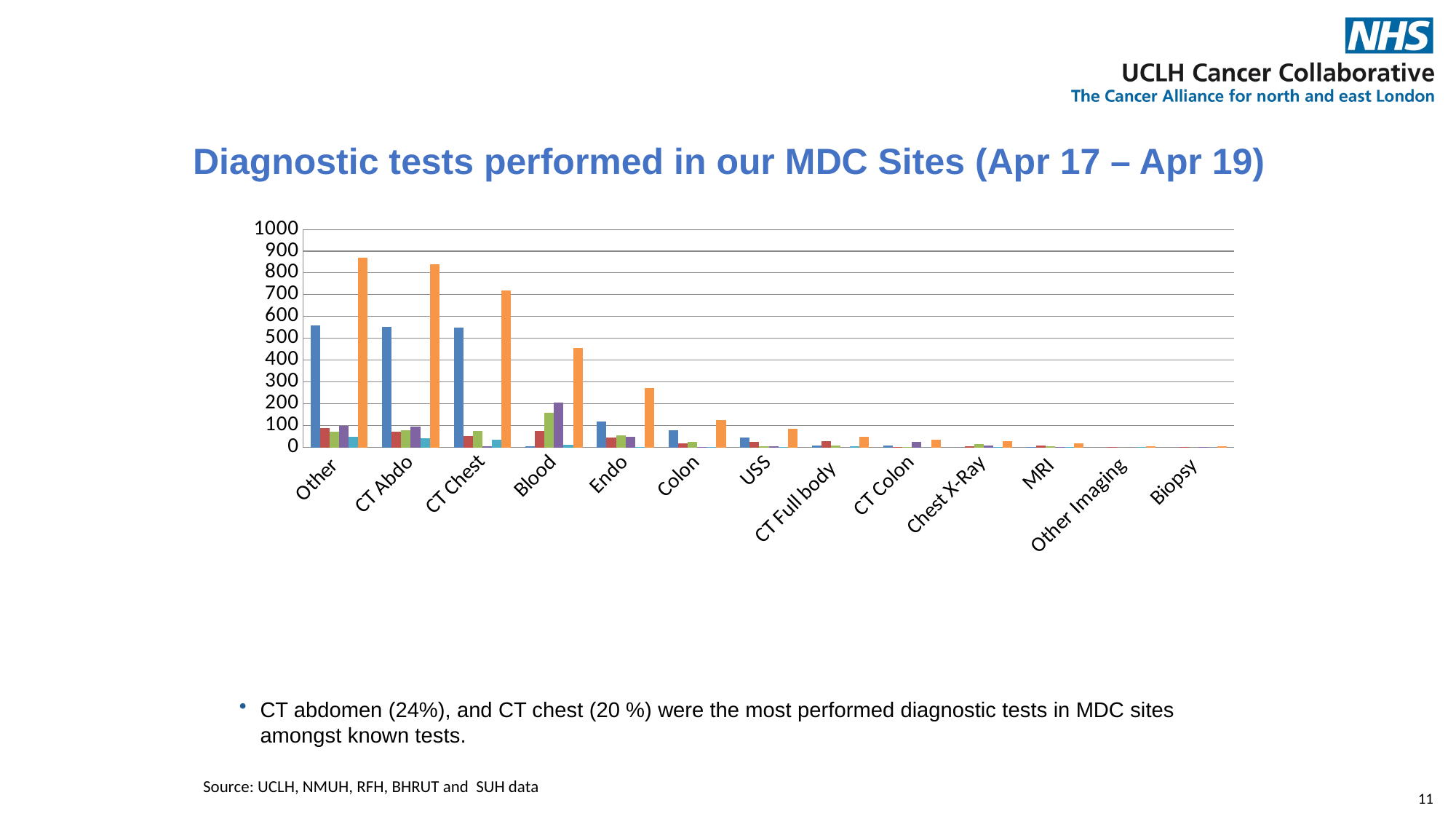
Which is larger: the orange bar for Blood or the orange bar for Endo? Blood Which category contains the tallest bar in the chart? Other How many categories are shown on the x axis of the chart? 13 Is the value of the tallest (orange) bar for Other greater or less than 800? greater Do the orange bars generally rise or fall moving from left to right along the x axis? fall Is the value of the orange bar for Endo greater or less than 300? less What kind of chart is shown on the slide? bar chart Is the value of the orange bar for Blood greater or less than 400? greater What is the title of the slide containing the chart? Diagnostic tests performed in our MDC Sites (Apr 17 – Apr 19)